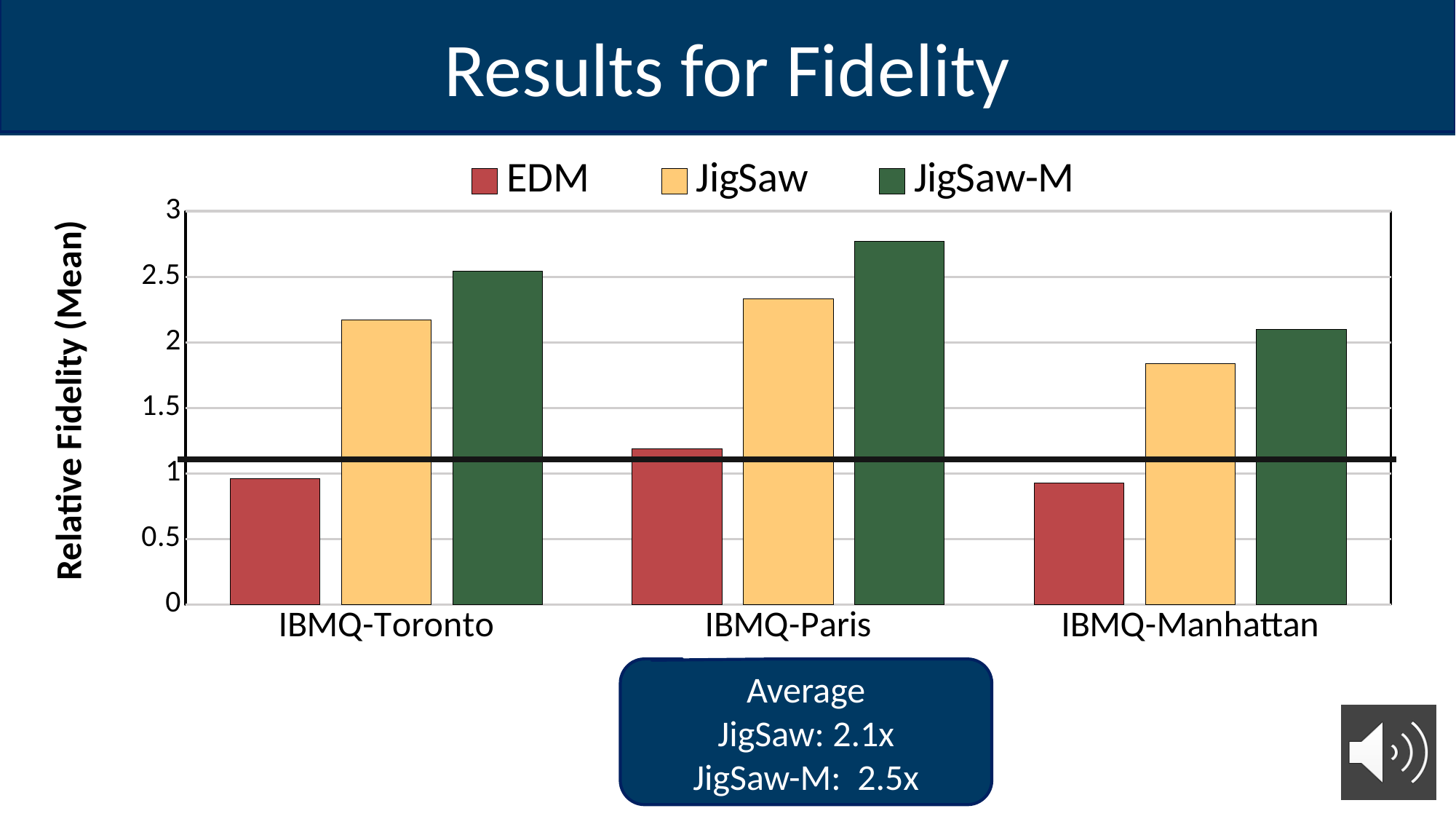
What kind of chart is shown on the slide? bar chart For which machine is the EDM bar the highest? IBMQ-Paris For which machine is the JigSaw bar the lowest? IBMQ-Manhattan For which machine is the JigSaw-M bar the highest? IBMQ-Paris Which series is shown in red in the legend? EDM What is the label on the y axis? Relative Fidelity (Mean) Is the EDM value for IBMQ-Toronto greater or less than 1? less Is the JigSaw value for IBMQ-Manhattan greater or less than 2? less How many quantum machines (categories) are shown on the x axis? 3 For IBMQ-Toronto, which is larger: the JigSaw bar or the JigSaw-M bar? JigSaw-M How many series does the legend list? 3 Is the JigSaw-M value for IBMQ-Paris greater or less than 2.5? greater